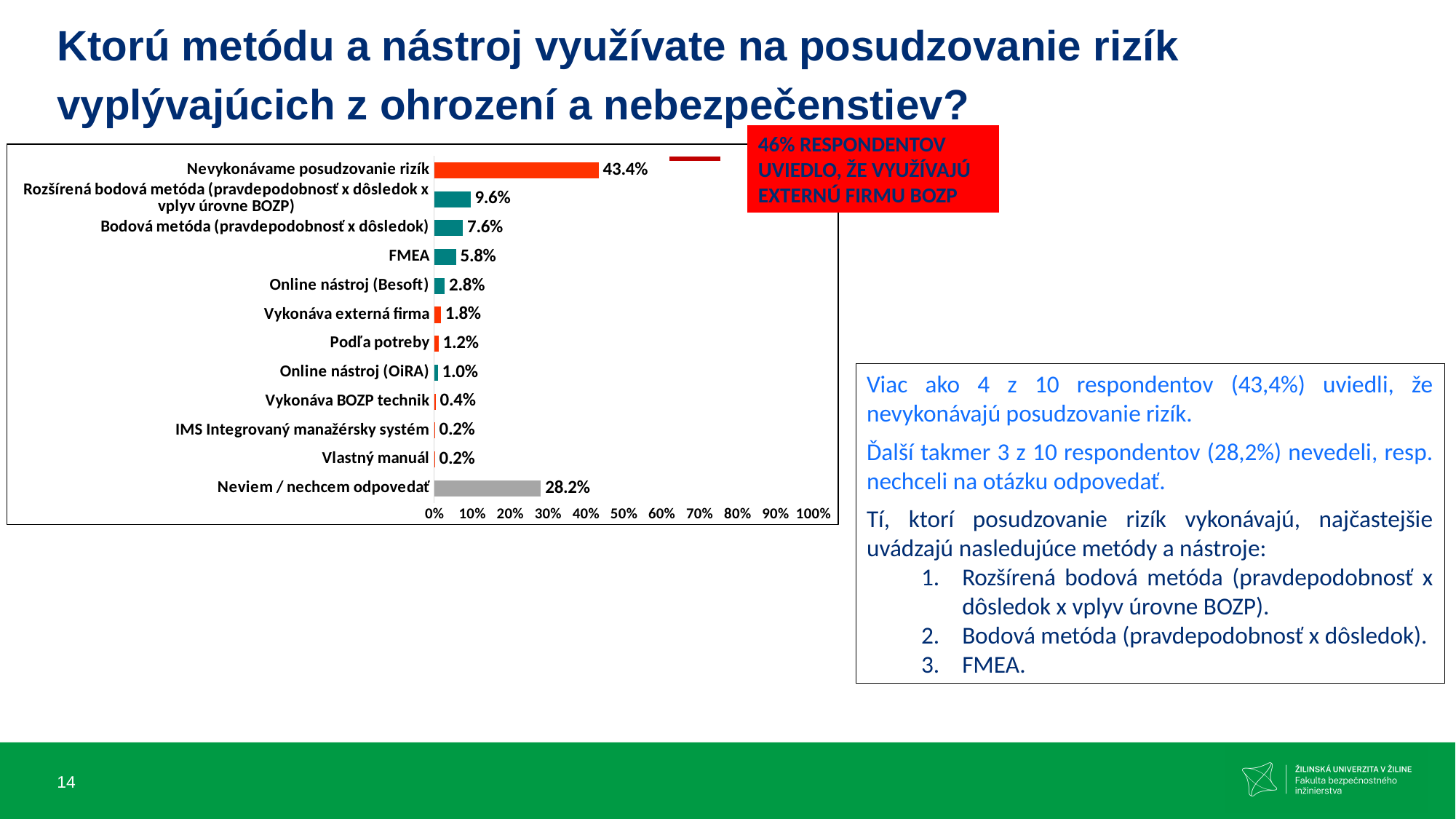
What is the value for "Nevykonávame posudzovanie rizík"? 43.4% What is the difference between the values for "Rozšírená bodová metóda (pravdepodobnosť x dôsledok x vplyv úrovne BOZP)" and "Bodová metóda (pravdepodobnosť x dôsledok)"? 2.0 percentage points Which category has the highest value? Nevykonávame posudzovanie rizík Which is larger, the value for "FMEA" or the value for "Online nástroj (Besoft)"? FMEA What is the difference between the values for "Nevykonávame posudzovanie rizík" and "Neviem / nechcem odpovedať"? 15.2 percentage points What kind of chart is shown on the slide? Bar chart What is the value for "Neviem / nechcem odpovedať"? 28.2% What is the value for "FMEA"? 5.8% What is the value for "Vykonáva externá firma"? 1.8% Is the value for "Nevykonávame posudzovanie rizík" greater or less than 40%? greater What is the value for "Online nástroj (Besoft)"? 2.8% How many categories are shown in the chart? 12